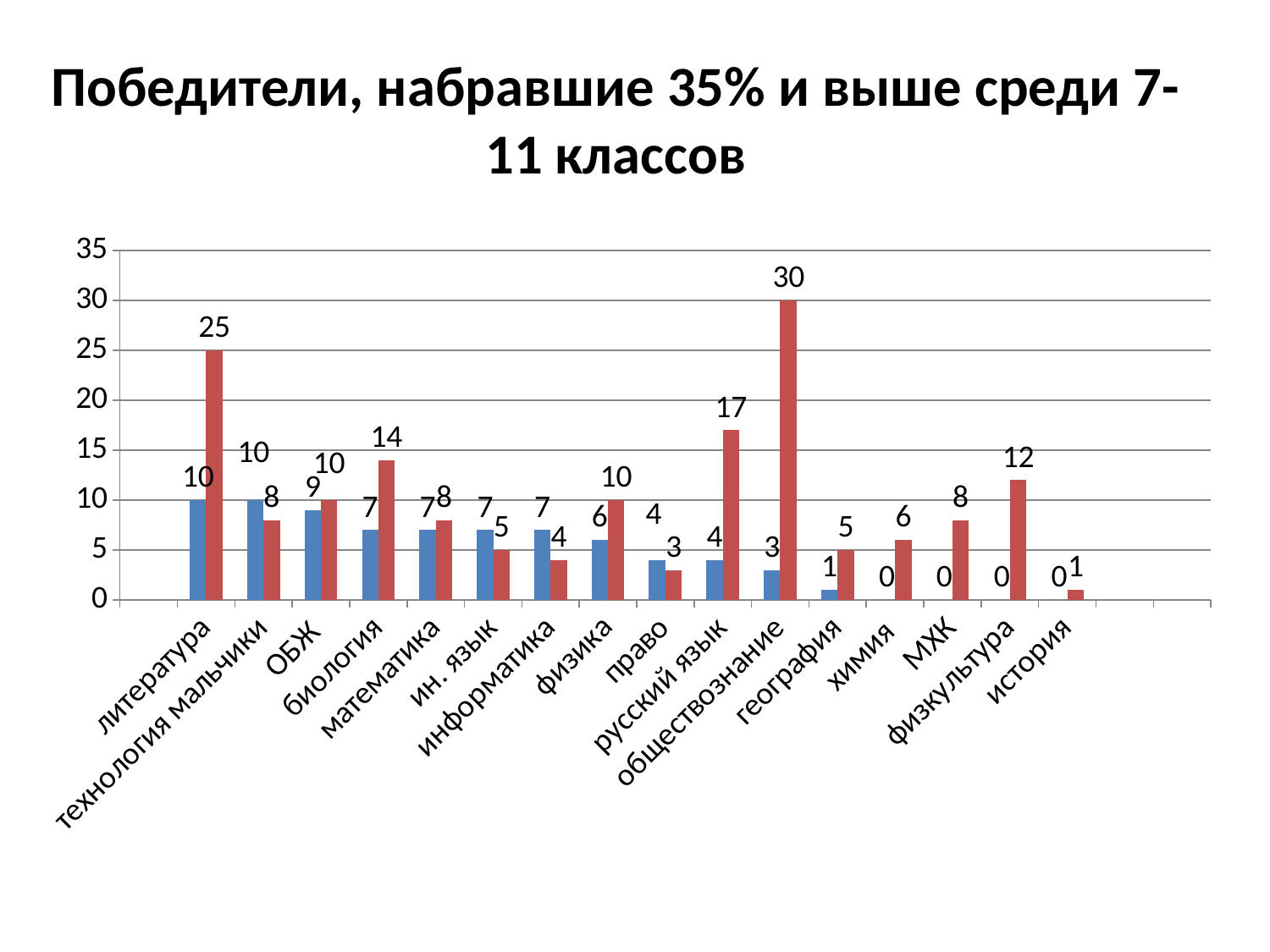
Which category has the highest red bar? обществознание What is the difference between the red bars for обществознание and русский язык? 13 What is the value of the red bar for русский язык? 17 What is the value of the blue bar for литература? 10 What type of chart is shown on the slide? bar chart Which is larger for биология, the blue bar or the red bar? the red bar How many categories are shown on the x axis? 16 Which is larger for информатика, the blue bar or the red bar? the blue bar Which category has the lowest red bar? история What is the value of the red bar for обществознание? 30 What is the title of the chart on the slide? Победители, набравшие 35% и выше среди 7-11 классов What is the difference between the red bar and the blue bar for литература? 15